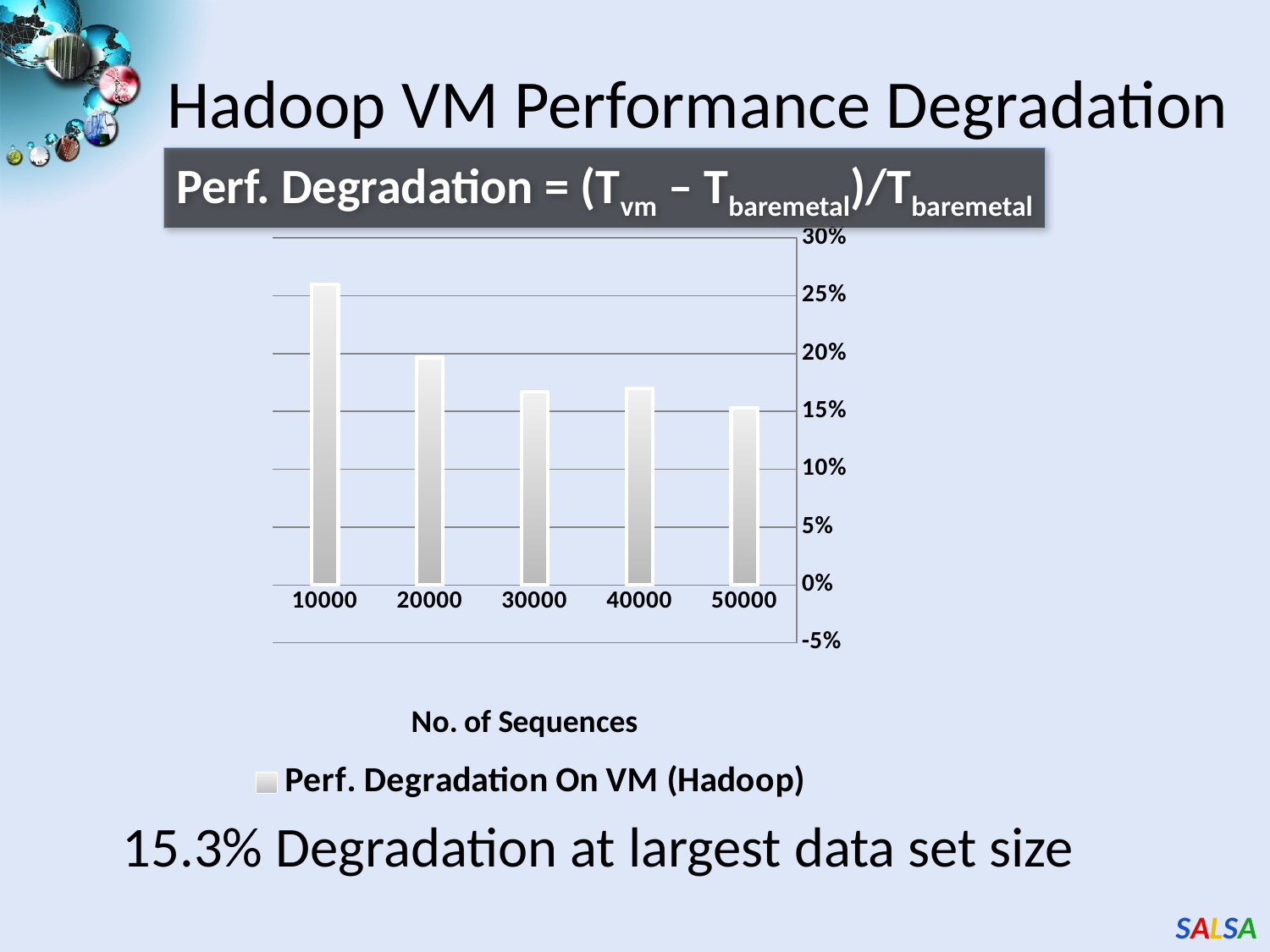
What kind of chart is shown on the slide? bar chart Is the value for 30000 sequences greater or less than 15%? greater Do the performance degradation values generally rise or fall as the number of sequences increases? fall Is the value for 10000 sequences greater or less than 25%? greater What is the series name shown in the legend? Perf. Degradation On VM (Hadoop) Which number of sequences has the lowest performance degradation? 50000 Which number of sequences has the highest performance degradation? 10000 How many series does the legend list? 1 Which has the larger performance degradation, 10000 sequences or 20000 sequences? 10000 How many categories (numbers of sequences) are plotted on the x axis? 5 What is the x-axis title of the chart? No. of Sequences